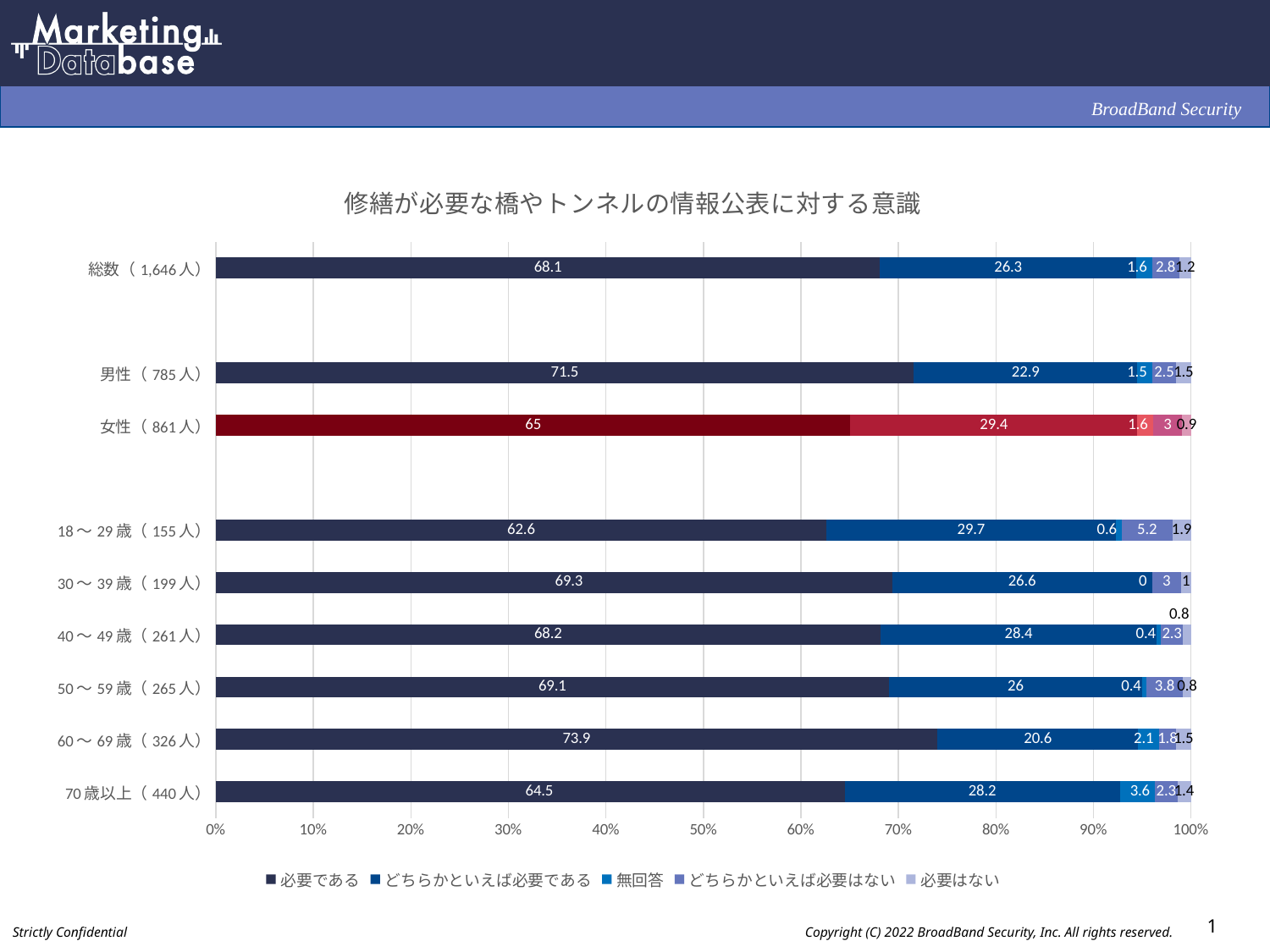
How many categories (bars) are plotted in the chart? 9 What is the difference between the 必要である values for 男性 (785人) and 女性 (861人)? 6.5 What is the value of 無回答 for 30～39歳 (199人)? 0 What is the title of the chart? 修繕が必要な橋やトンネルの情報公表に対する意識 Which is larger, the どちらかといえば必要である value for 70歳以上 (440人) or for 60～69歳 (326人)? 70歳以上 (440人) What kind of chart is shown on the slide? Stacked bar chart What is the value of どちらかといえば必要はない for 18～29歳 (155人)? 5.2 What is the value of 必要である for 総数 (1,646人)? 68.1 Which category has the highest value for 必要である? 60～69歳 (326人) Which category has the lowest value for 必要である? 18～29歳 (155人) What is the value of どちらかといえば必要である for 女性 (861人)? 29.4 How many series does the legend list? 5